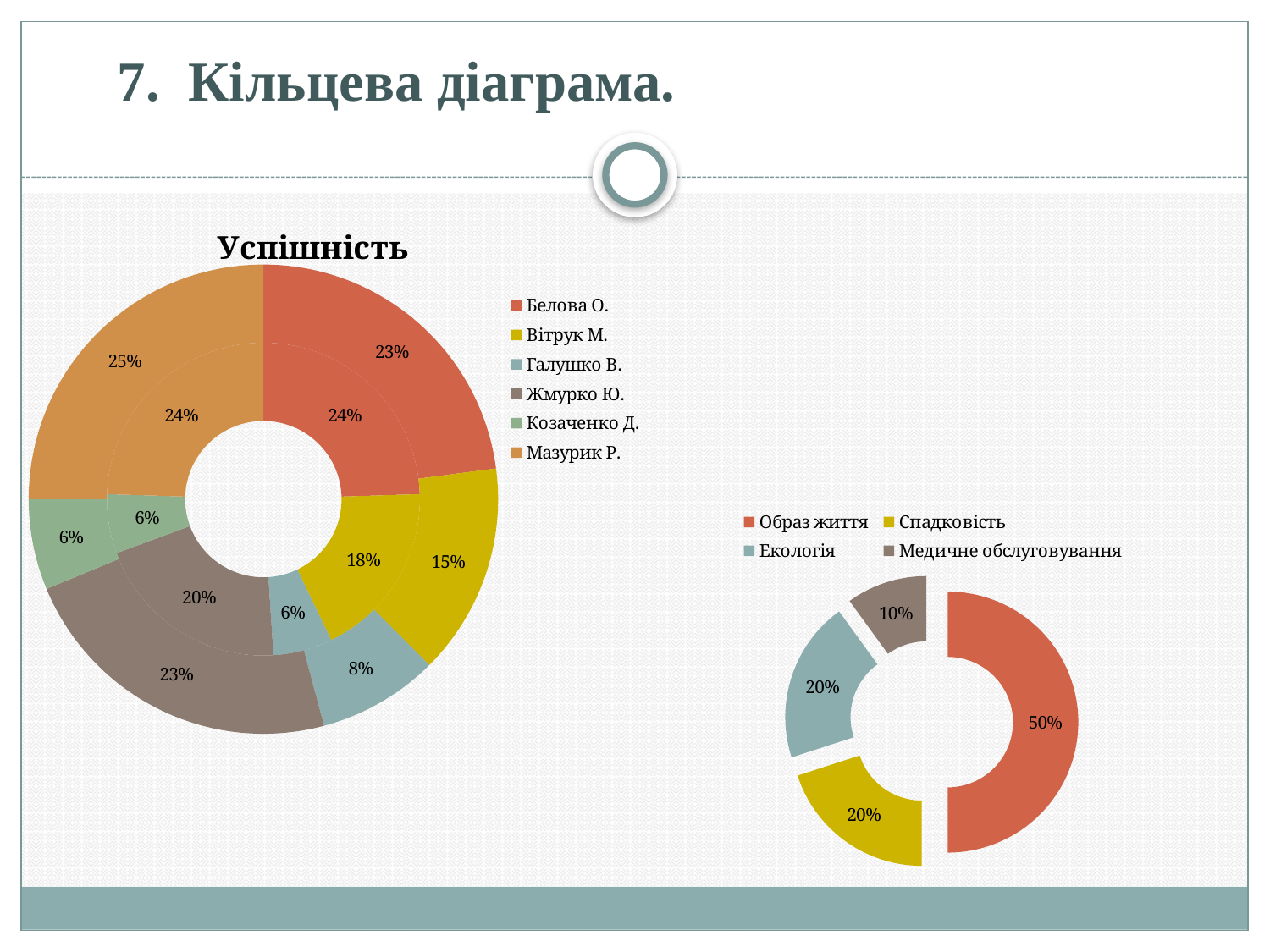
In the right-hand doughnut chart, what is the difference between the shares of Образ життя and Екологія? 30% In the right-hand doughnut chart, what share is shown for Медичне обслуговування? 10% In the chart titled Успішність, what value is shown for Жмурко Ю. in the inner ring? 20% In the chart titled Успішність, what value is shown for Мазурик Р. in the outer ring? 25% In the right-hand doughnut chart, which category has the smallest share? Медичне обслуговування In the right-hand doughnut chart, which category has the largest share? Образ життя What type of chart is the chart titled Успішність? Doughnut chart In the chart titled Успішність, which category has the largest value in the outer ring? Мазурик Р. How many categories does the legend of the chart titled Успішність list? 6 How many categories does the legend of the right-hand doughnut chart list? 4 In the chart titled Успішність, what value is shown for Галушко В. in the outer ring? 8% In the right-hand doughnut chart, what share is shown for Образ життя? 50%